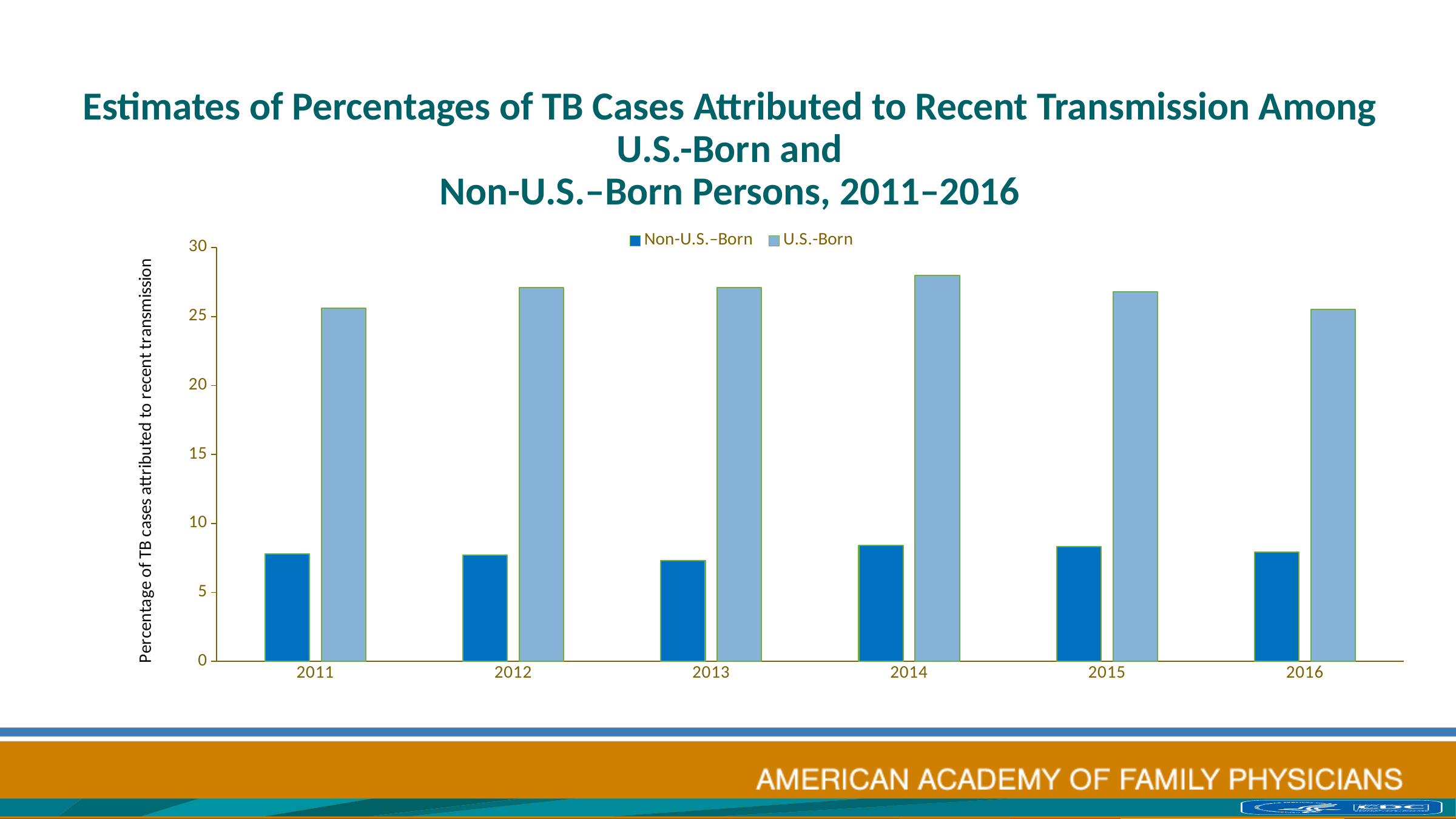
Which is larger: the U.S.-Born value for 2012 or for 2016? 2012 In which year is the Non-U.S.–Born value lowest? 2013 Is the U.S.-Born value for 2014 greater or less than 30? less Which series does the darker blue bar represent? Non-U.S.–Born Is the Non-U.S.–Born value for 2013 greater or less than 10? less Is the U.S.-Born value for 2011 greater or less than 25? greater In which year is the U.S.-Born value highest? 2014 In 2011, which is larger: the U.S.-Born value or the Non-U.S.–Born value? U.S.-Born What is the label of the vertical axis? Percentage of TB cases attributed to recent transmission How many series does the legend list? 2 How many years are shown on the x axis? 6 What kind of chart is shown on the slide? bar chart